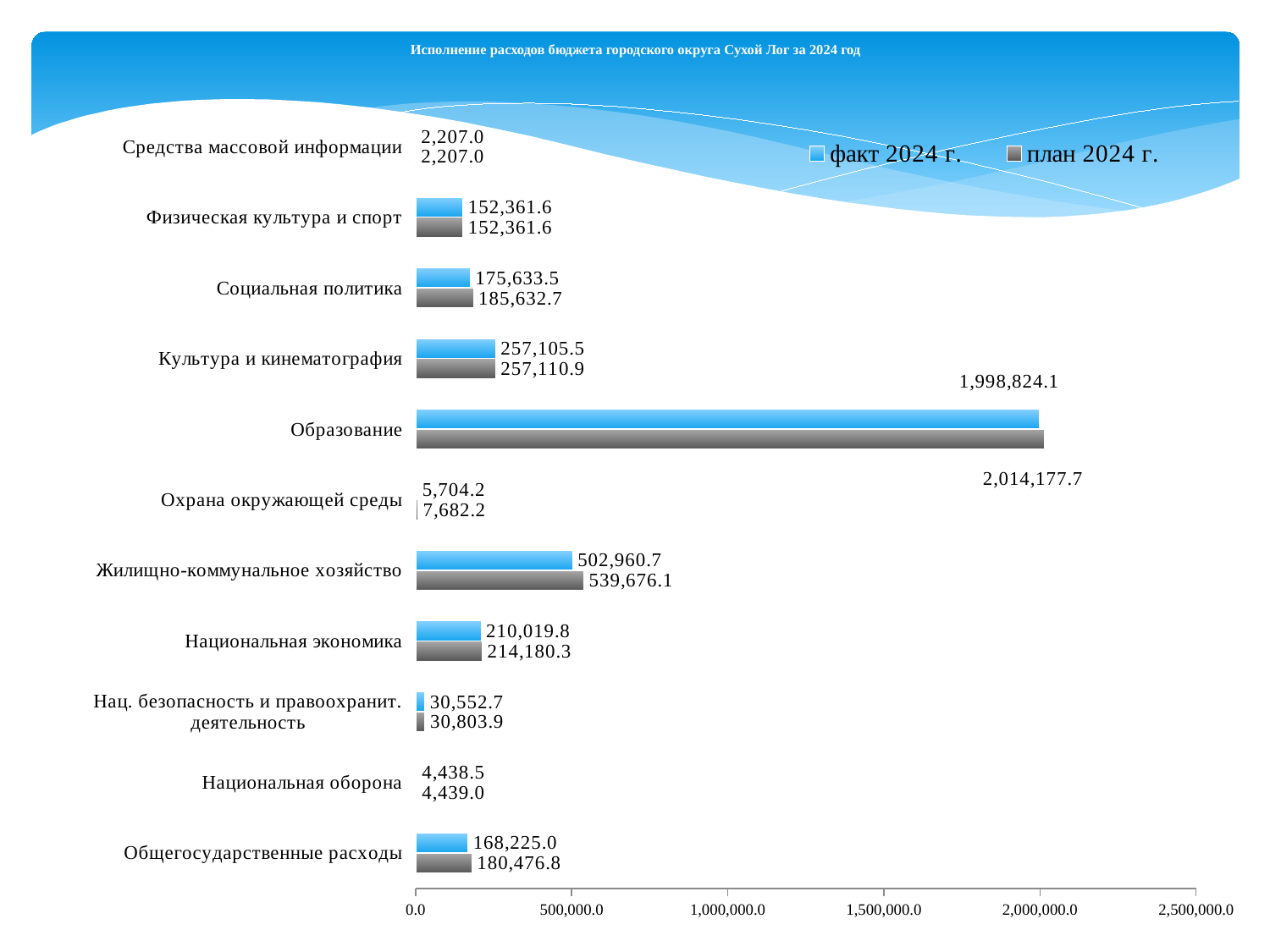
What is the difference between the план 2024 г. and факт 2024 г. values for Жилищно-коммунальное хозяйство? 36,715.4 Is the план 2024 г. value for Образование greater or less than 2,000,000.0? greater What is the план 2024 г. value for Жилищно-коммунальное хозяйство? 539,676.1 How many series does the legend list? 2 How many categories are shown on the chart? 11 What is the difference between the план 2024 г. and факт 2024 г. values for Образование? 15,353.6 Which category has the highest план 2024 г. value? Образование Which category has the lowest факт 2024 г. value? Средства массовой информации What type of chart is shown on the slide? bar chart What is the факт 2024 г. value for Охрана окружающей среды? 5,704.2 Which is larger: the факт 2024 г. value for Национальная экономика or the факт 2024 г. value for Общегосударственные расходы? Национальная экономика What is the факт 2024 г. value for Образование? 1,998,824.1